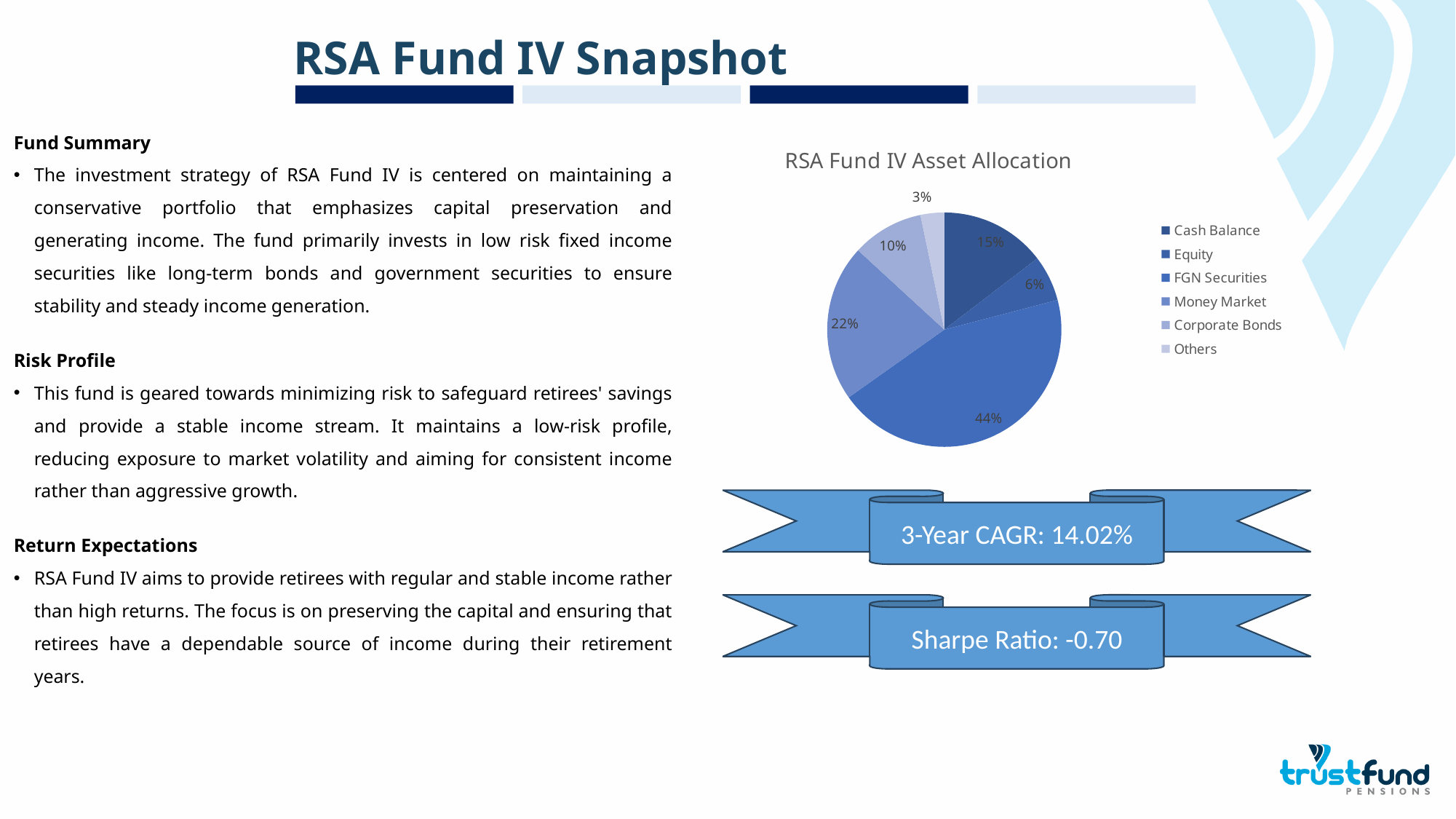
What type of chart is the RSA Fund IV Asset Allocation chart? Pie chart What share of the RSA Fund IV Asset Allocation pie is Corporate Bonds? 10% What is the title of the pie chart on the slide? RSA Fund IV Asset Allocation Which category has the smallest slice in the RSA Fund IV Asset Allocation pie? Others What share of the RSA Fund IV Asset Allocation pie is Cash Balance? 15% What share of the RSA Fund IV Asset Allocation pie is Money Market? 22% In the RSA Fund IV Asset Allocation pie, which is larger: Cash Balance or Corporate Bonds? Cash Balance In the RSA Fund IV Asset Allocation pie, what is the difference between the FGN Securities share and the Money Market share? 22% How many categories does the RSA Fund IV Asset Allocation pie chart show? 6 Which category has the largest slice in the RSA Fund IV Asset Allocation pie? FGN Securities